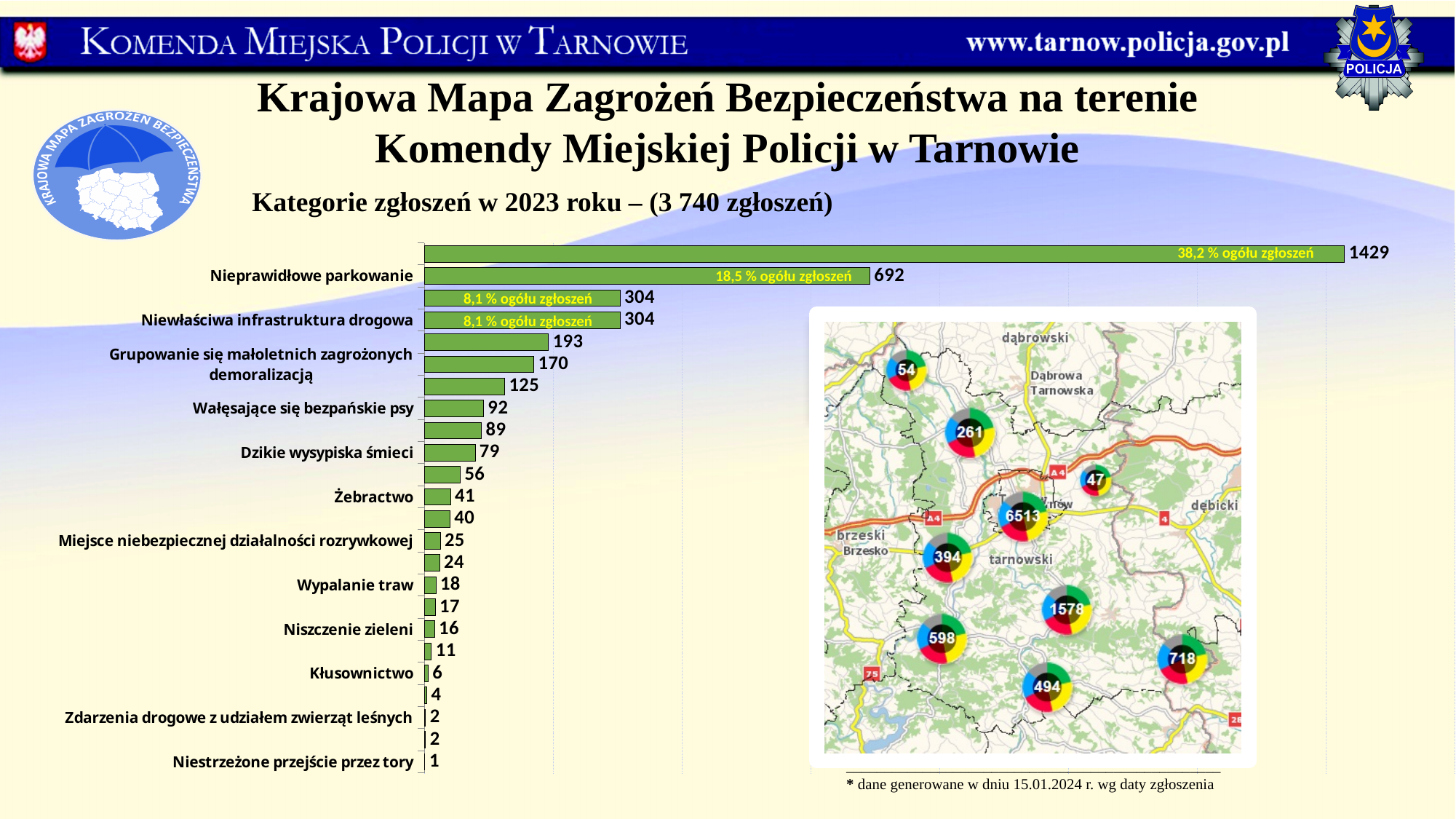
What percentage of all reports does the bar for Nieprawidłowe parkowanie represent, according to its label? 18,5 % ogółu zgłoszeń How many bars are plotted in the chart? 24 What kind of chart is shown on the slide? bar chart Which labelled category has the lowest value? Niestrzeżone przejście przez tory What is the value for Kłusownictwo? 6 What is the value for Niewłaściwa infrastruktura drogowa? 304 What is the value of the longest bar in the chart? 1429 What is the difference between the values for Nieprawidłowe parkowanie and Niewłaściwa infrastruktura drogowa? 388 What is the value for Nieprawidłowe parkowanie? 692 Which is larger: the value for Wałęsające się bezpańskie psy or for Dzikie wysypiska śmieci? Wałęsające się bezpańskie psy What is the value for Żebractwo? 41 What is the value for Wałęsające się bezpańskie psy? 92